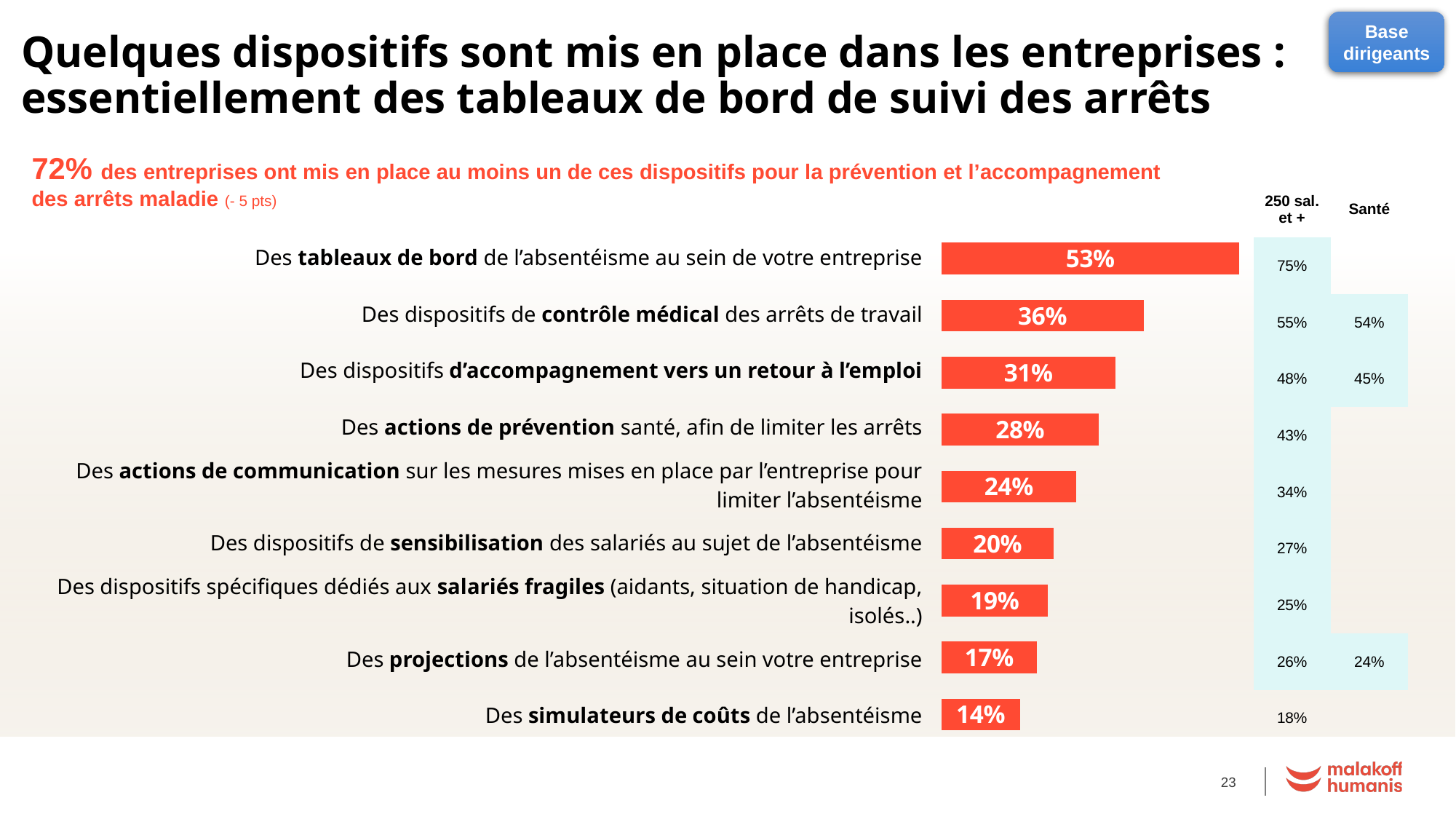
In the '250 sal. et +' column, what is the value for tableaux de bord de l'absentéisme? 75% Do the values rise or fall going from the top bar to the bottom bar? Fall What is the value for simulateurs de coûts de l'absentéisme? 14% How many dispositifs (categories) are shown in the bar chart? 9 What is the difference between the value for tableaux de bord and the value for contrôle médical? 17% What kind of chart is used on this slide? Bar chart What is the value for dispositifs de contrôle médical des arrêts de travail? 36% Which is larger: the value for actions de prévention santé or the value for actions de communication? Des actions de prévention santé Which dispositif has the lowest percentage in the bar chart? Des simulateurs de coûts de l'absentéisme What percentage of companies have set up tableaux de bord de l'absentéisme? 53% What colour are the bars in the chart? Red Which dispositif has the highest percentage in the bar chart? Des tableaux de bord de l'absentéisme au sein de votre entreprise